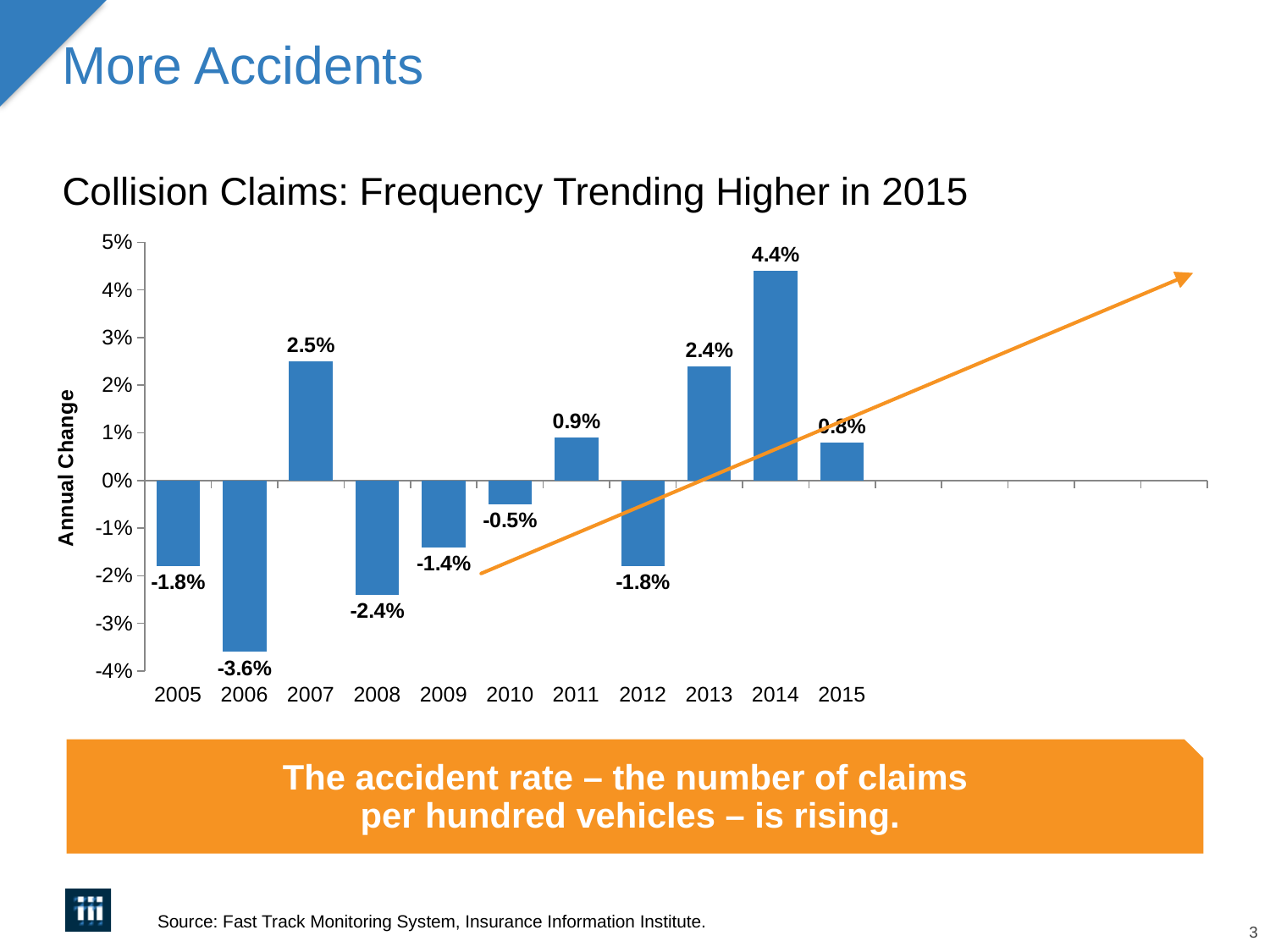
How many years in the chart show a negative annual change? 6 Which year shows a larger decline, 2008 or 2009? 2008 What is the label on the vertical axis of the chart? Annual Change Which year has the highest annual change in the chart? 2014 What is the annual change in collision claim frequency shown for 2014? 4.4% What is the annual change shown for 2012? -1.8% Is the value for 2009 greater or less than -1%? less What kind of chart is used to show the annual change in collision claims? Bar chart How many years are shown on the x axis of the chart? 11 What is the annual change shown for 2006? -3.6% What is the difference between the annual change in 2014 and in 2013? 2.0 percentage points Which year has the lowest annual change in the chart? 2006